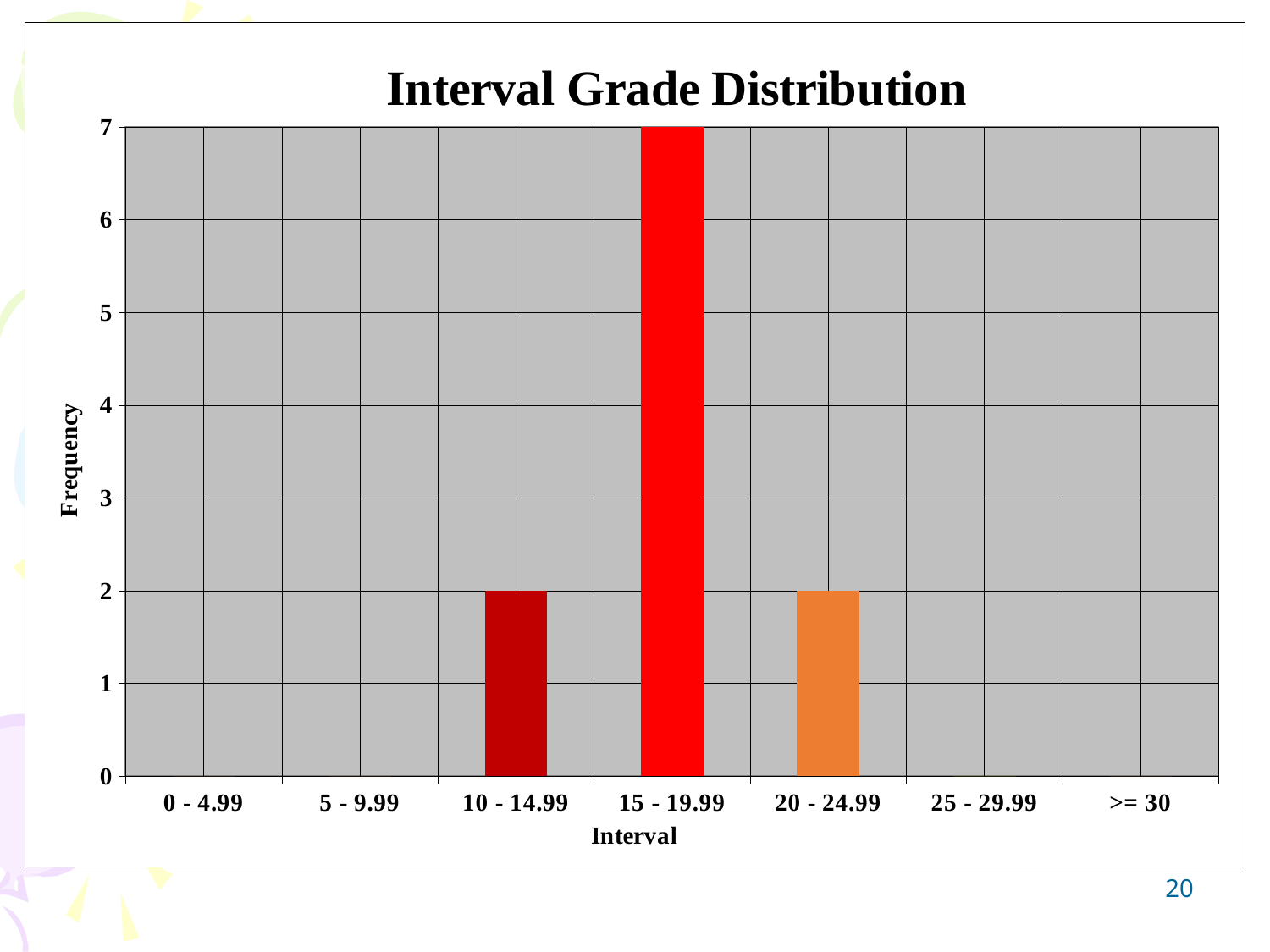
Which interval has the highest frequency? 15 - 19.99 How many intervals are shown on the x axis? 7 What is the difference in frequency between the 15 - 19.99 interval and the 10 - 14.99 interval? 5 What is the frequency for the 0 - 4.99 interval? 0 What is the frequency for the 15 - 19.99 interval? 7 What is the frequency for the 20 - 24.99 interval? 2 What is the label of the y axis? Frequency What type of chart is shown on the slide? bar chart What is the frequency for the 10 - 14.99 interval? 2 What is the title of the chart? Interval Grade Distribution Which has a higher frequency, the 15 - 19.99 interval or the 20 - 24.99 interval? 15 - 19.99 Is the frequency for the 15 - 19.99 interval greater or less than 5? greater